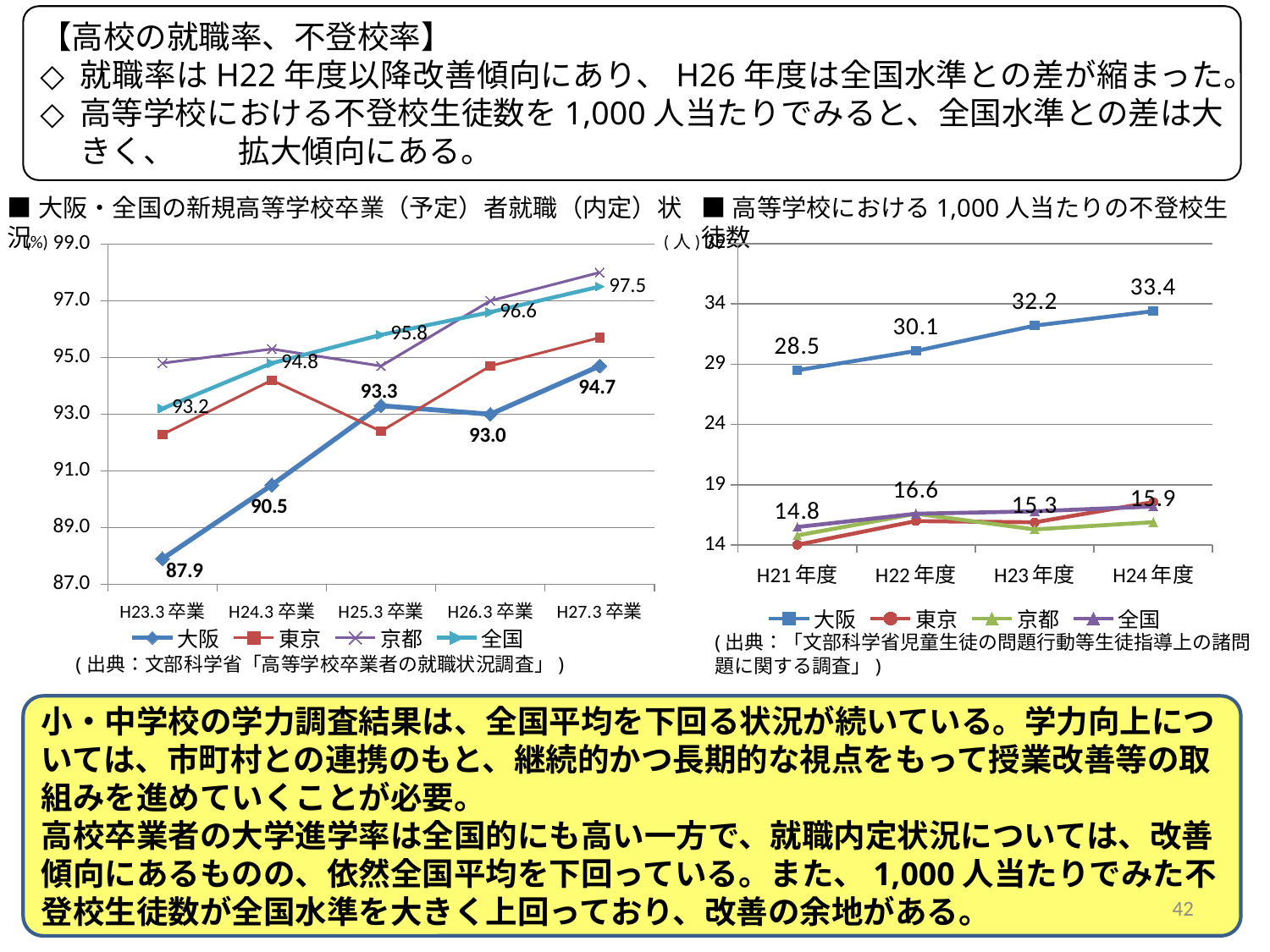
In the left chart (就職（内定）状況), does the 全国 line rise or fall from H23.3卒業 to H27.3卒業? Rises In the right chart (1,000人当たりの不登校生徒数), what is the difference between the 大阪 values at H24年度 and H21年度? 4.9 In the left chart (就職（内定）状況), what is the value for 大阪 at H23.3卒業? 87.9 In the right chart (1,000人当たりの不登校生徒数), in which year is the 大阪 value highest? H24年度 In the left chart (就職（内定）状況), how many graduation years are shown on the x axis? 5 In the left chart (就職（内定）状況), what is the value for 全国 at H27.3卒業? 97.5 In the left chart (就職（内定）状況), how many series does the legend list? 4 In the left chart (就職（内定）状況), what is the value for 大阪 at H27.3卒業? 94.7 What kind of chart is the left chart (大阪・全国の新規高等学校卒業（予定）者就職（内定）状況)? Line chart In the right chart (1,000人当たりの不登校生徒数), what is the value for 大阪 at H24年度? 33.4 In the left chart (就職（内定）状況), what is the difference between 全国 and 大阪 at H27.3卒業? 2.8 In the left chart (就職（内定）状況), which is larger at H25.3卒業, 大阪 or 東京? 大阪